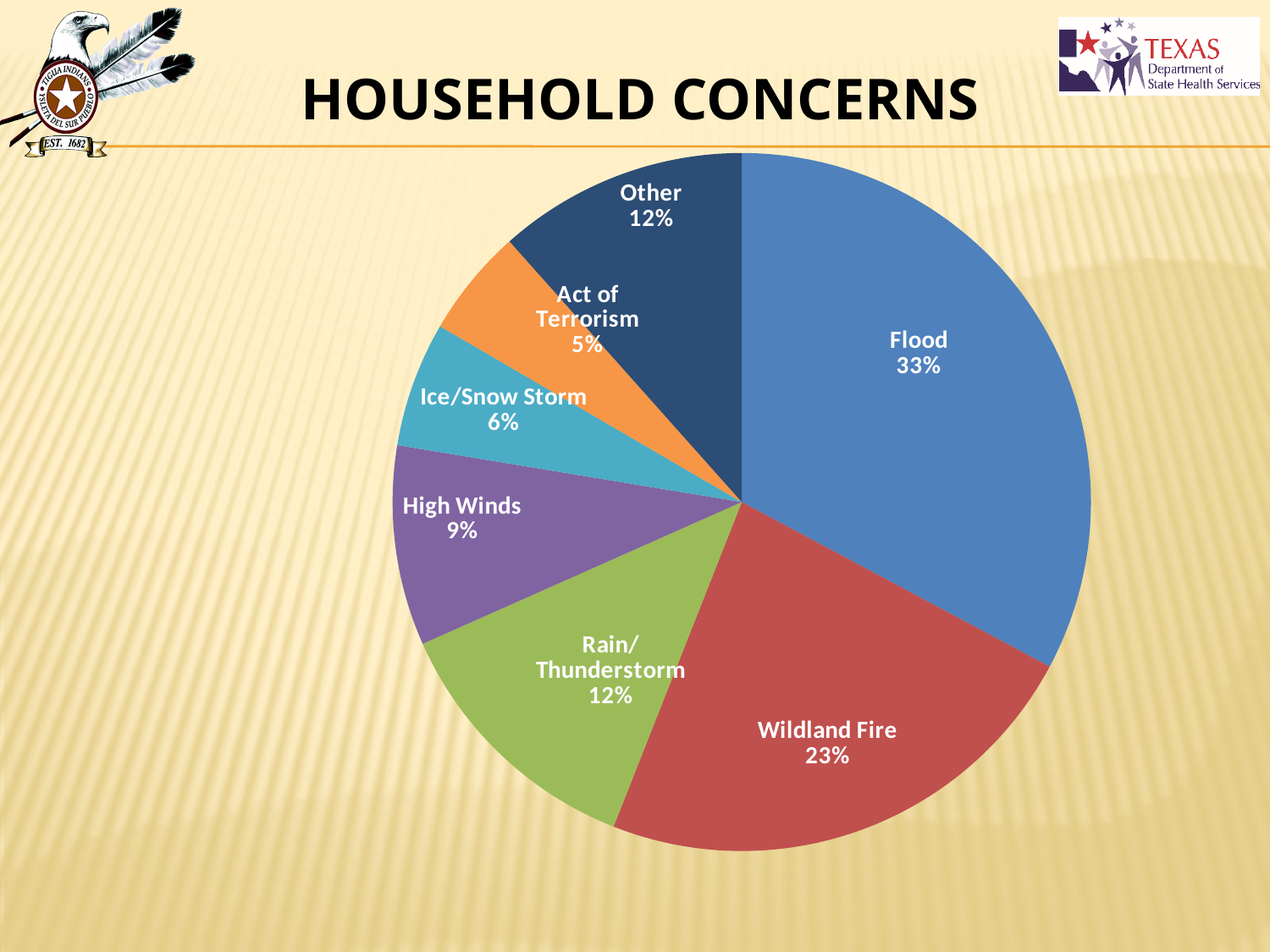
What percentage of household concerns is Act of Terrorism? 5% What is the combined share of Rain/Thunderstorm and Other? 24% What percentage of household concerns is Flood? 33% What percentage of household concerns is Wildland Fire? 23% Which household concern has the largest share? Flood What percentage of household concerns is High Winds? 9% Which is larger, the share for High Winds or the share for Ice/Snow Storm? High Winds What is the difference in percentage points between Flood and Wildland Fire? 10 What type of chart is shown on the slide? pie chart Which household concern has the smallest share? Act of Terrorism What is the title of the chart? HOUSEHOLD CONCERNS How many slices does the pie chart have? 7